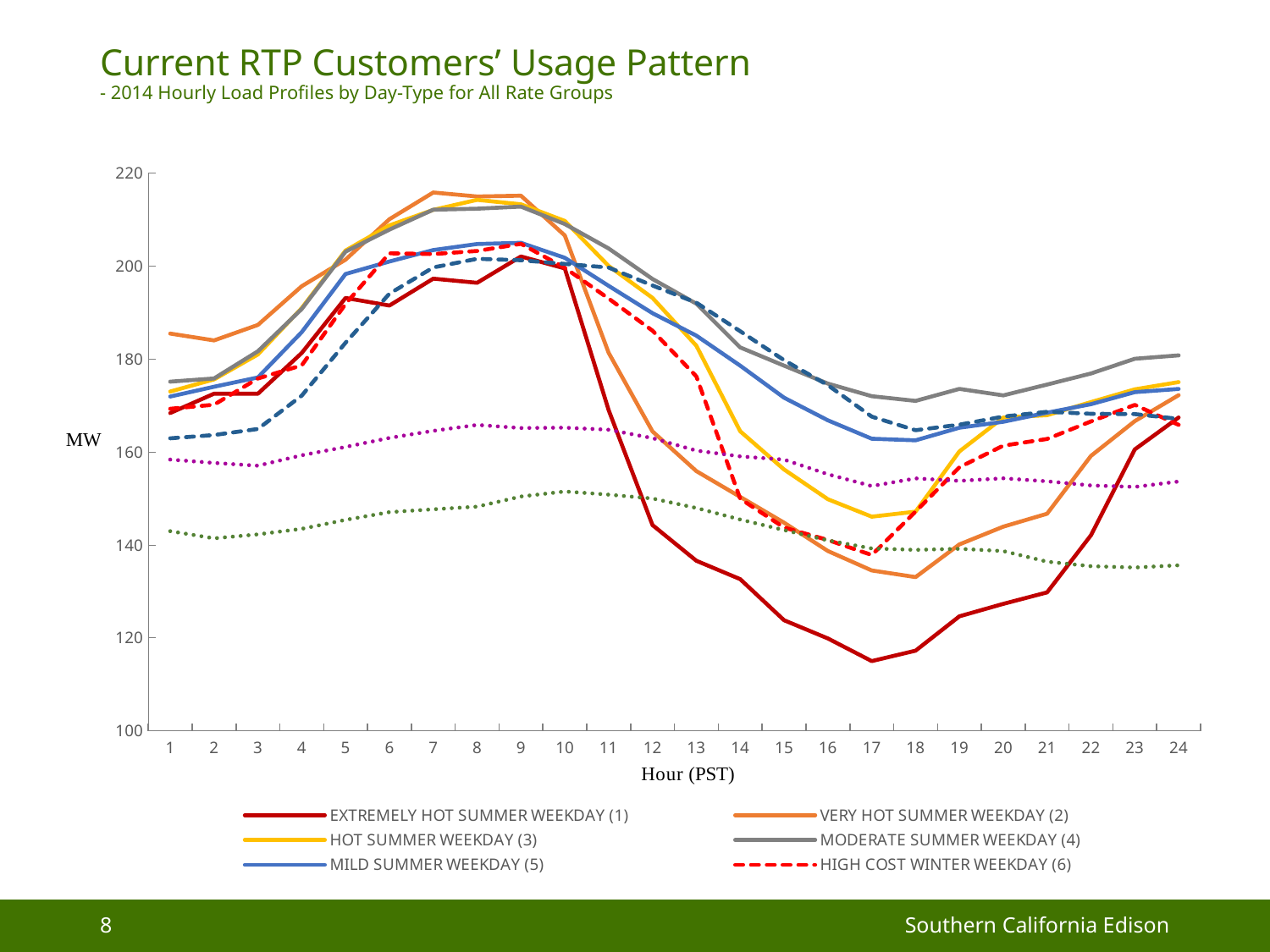
Which legend series has the lowest value at hour 17? Extremely Hot Summer Weekday (1) Does the Extremely Hot Summer Weekday (1) line rise or fall from hour 10 to hour 17? fall How many hours are shown along the x axis? 24 Is the value for Very Hot Summer Weekday (2) at hour 7 greater or less than 200? greater Is the value for Moderate Summer Weekday (4) at hour 18 greater or less than 180? less At hour 12, which is higher: Mild Summer Weekday (5) or Extremely Hot Summer Weekday (1)? Mild Summer Weekday (5) Is the value for Extremely Hot Summer Weekday (1) at hour 17 greater or less than 120? less Does the Very Hot Summer Weekday (2) line rise or fall from hour 1 to hour 7? rise How many series does the legend list? 6 What is the label of the x axis? Hour (PST) What kind of chart is shown on the slide? line chart